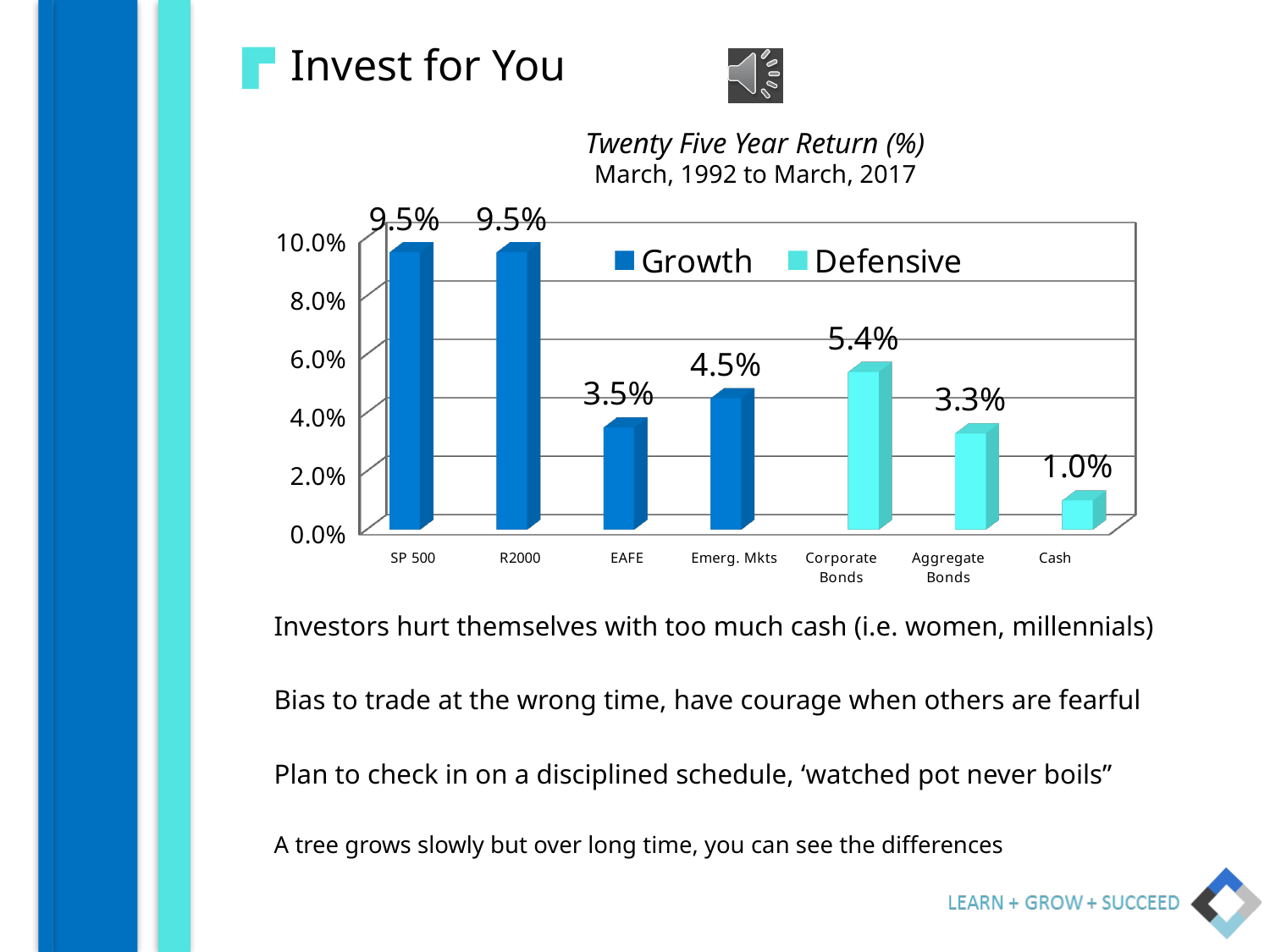
How many categories are shown on the x axis of the chart? 7 What kind of chart is shown on the slide? Bar chart What is the difference between the returns for Corporate Bonds and Aggregate Bonds? 2.1% What is the twenty five year return for Corporate Bonds? 5.4% What is the twenty five year return for EAFE? 3.5% What time period does the chart subtitle give? March, 1992 to March, 2017 How many series does the chart legend list? 2 Which has a higher return, EAFE or Aggregate Bonds? EAFE What is the difference between the returns for SP 500 and Emerg. Mkts? 5.0% Which has a higher return, Emerg. Mkts or Corporate Bonds? Corporate Bonds Which category has the lowest twenty five year return? Cash What is the twenty five year return for Cash? 1.0%